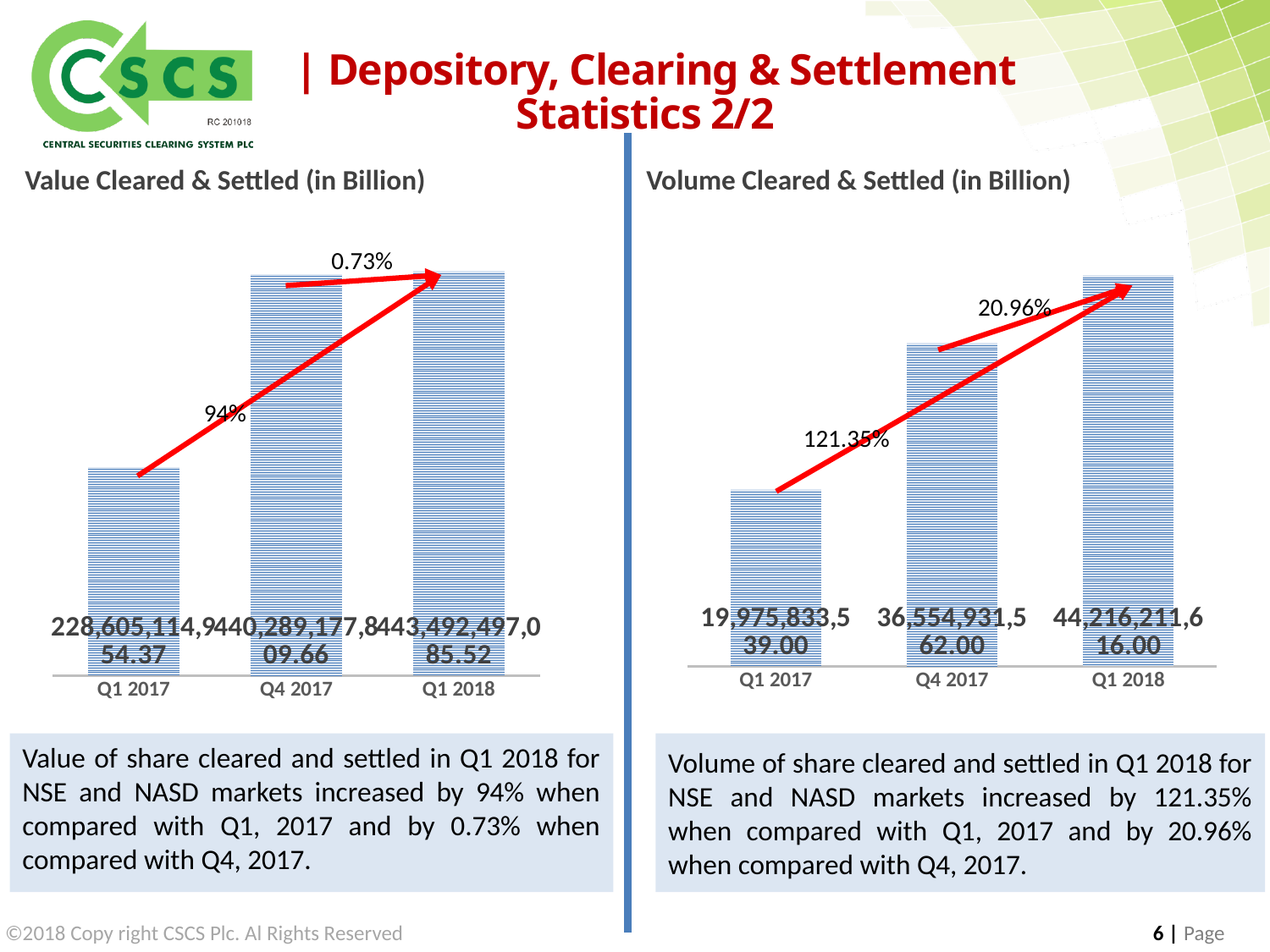
What kind of chart is the 'Value Cleared & Settled (in Billion)' chart on the left? Bar chart How many categories are shown on the x axis of the 'Volume Cleared & Settled (in Billion)' chart on the right? 3 In the 'Volume Cleared & Settled (in Billion)' chart, what percentage change is annotated between Q4 2017 and Q1 2018? 20.96% In the 'Volume Cleared & Settled (in Billion)' chart, is the bar for Q4 2017 taller or shorter than the bar for Q1 2017? Taller In the 'Volume Cleared & Settled (in Billion)' chart, do the bars rise or fall from Q1 2017 to Q1 2018? Rise In the 'Value Cleared & Settled (in Billion)' chart, what percentage change is annotated between Q1 2017 and Q1 2018? 94% In the 'Volume Cleared & Settled (in Billion)' chart, what percentage change is annotated between Q1 2017 and Q1 2018? 121.35% In the 'Volume Cleared & Settled (in Billion)' chart, which quarter has the lowest bar? Q1 2017 In the 'Value Cleared & Settled (in Billion)' chart, which quarter has the lowest bar? Q1 2017 In the 'Volume Cleared & Settled (in Billion)' chart, which quarter has the highest bar? Q1 2018 In the 'Value Cleared & Settled (in Billion)' chart, what percentage change is annotated between Q4 2017 and Q1 2018? 0.73% What is the title of the chart on the left side of the slide? Value Cleared & Settled (in Billion)